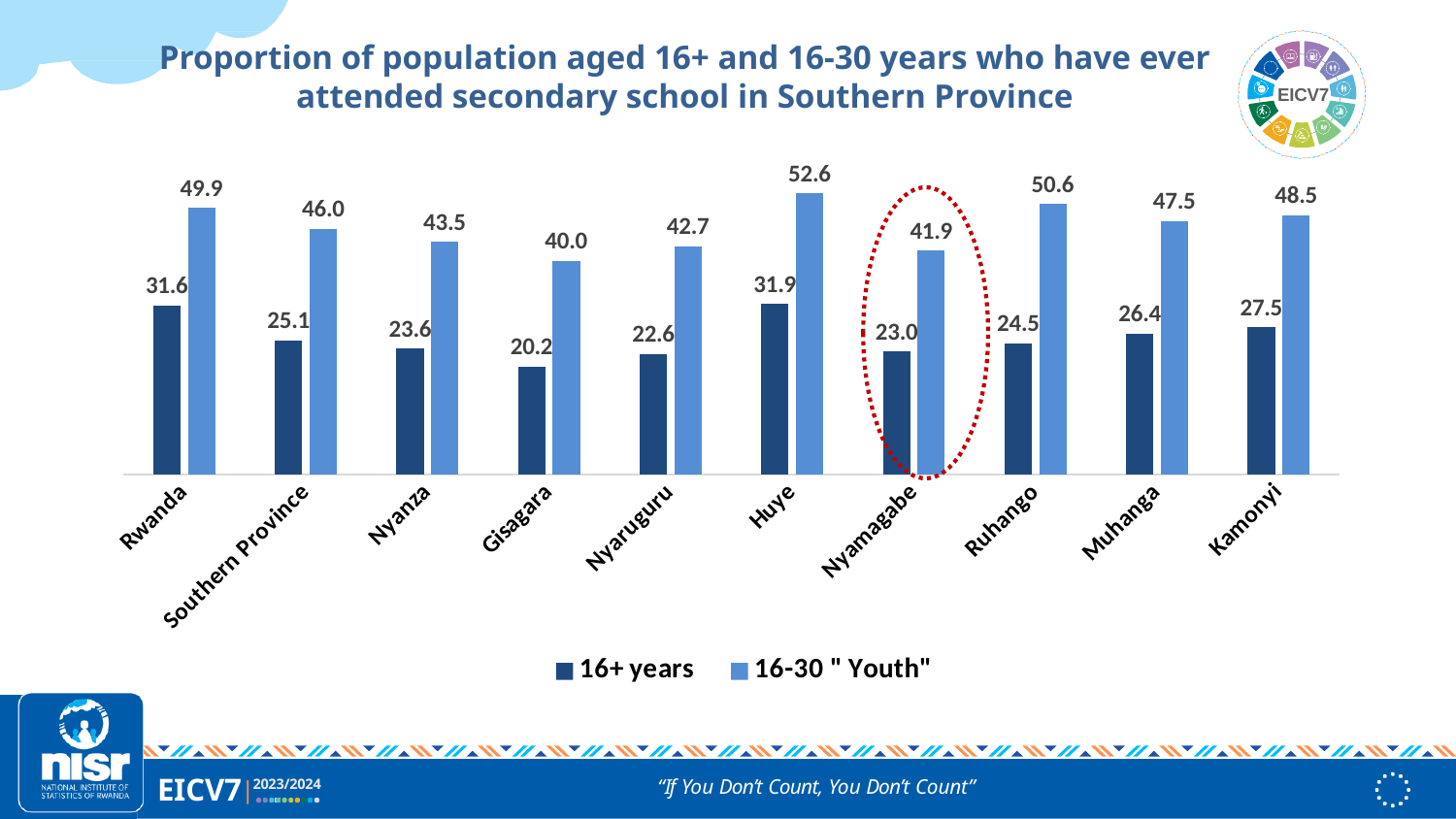
What is the difference between the 16-30 "Youth" values for Ruhango and Nyaruguru? 7.9 How many series does the legend list? 2 What is the value for the 16+ years series for Huye? 31.9 Which category is highlighted with a red dotted circle? Nyamagabe What kind of chart is shown on the slide? Bar chart What is the value for the 16+ years series for Southern Province? 25.1 What is the value for the 16-30 "Youth" series for Nyamagabe? 41.9 How many categories are shown on the x axis? 10 Which category has the lowest value in the 16+ years series? Gisagara Which category has the highest value in the 16-30 "Youth" series? Huye What is the difference between the 16-30 "Youth" and 16+ years values for Rwanda? 18.3 Which is larger: the 16+ years value for Muhanga or for Kamonyi? Kamonyi